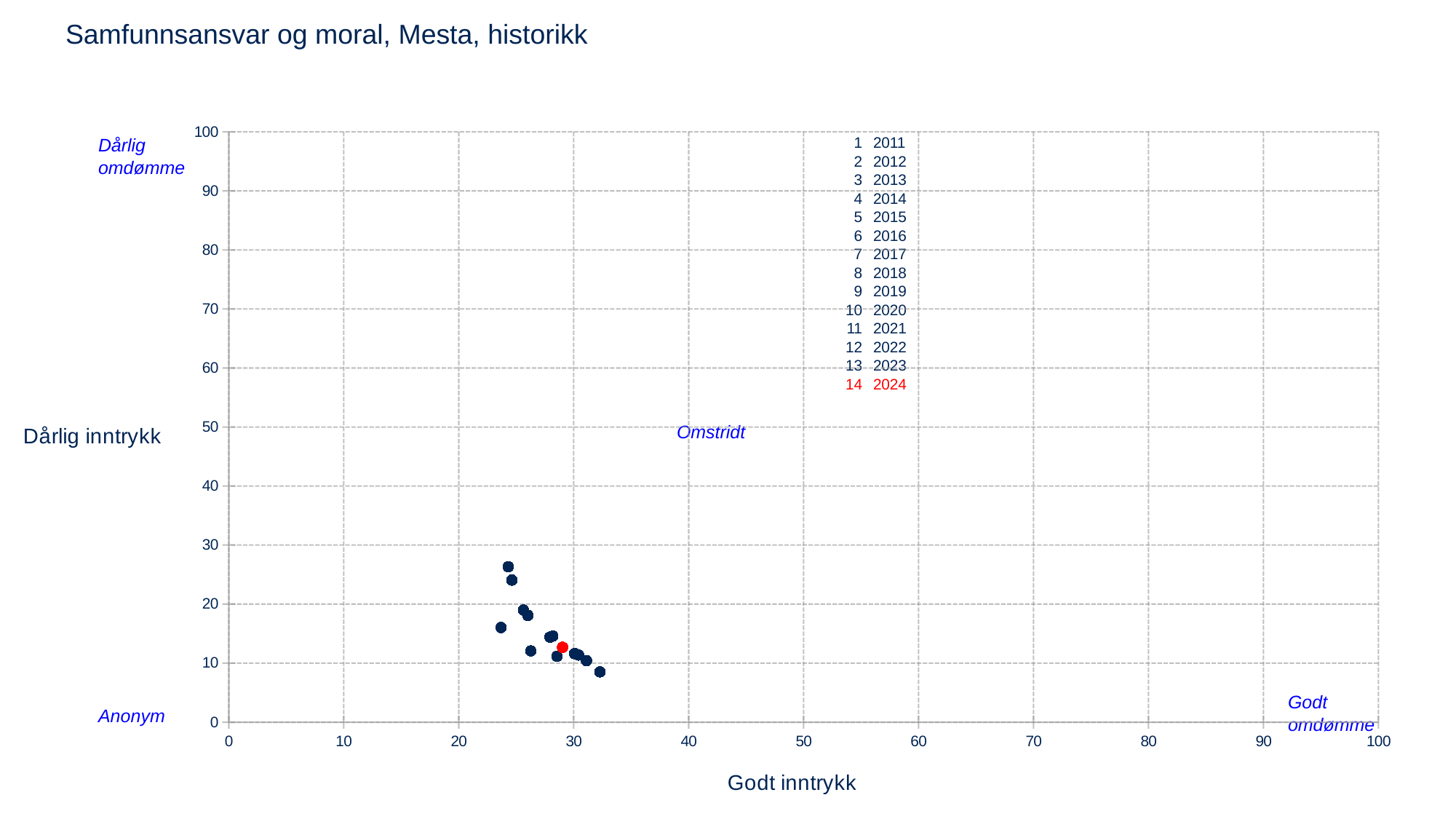
What kind of chart is shown on the slide? Scatter chart Are the x values of all plotted points greater or less than 50? less Is the x value (Godt inntrykk) of the red 2024 point greater or less than 40? less Are the y values of all plotted points greater or less than 30? less What is the title of the chart? Samfunnsansvar og moral, Mesta, historikk Which year is shown in red in the legend? 2024 What is the maximum value shown on the y axis? 100 How many years does the legend list? 14 What is the first year listed in the legend? 2011